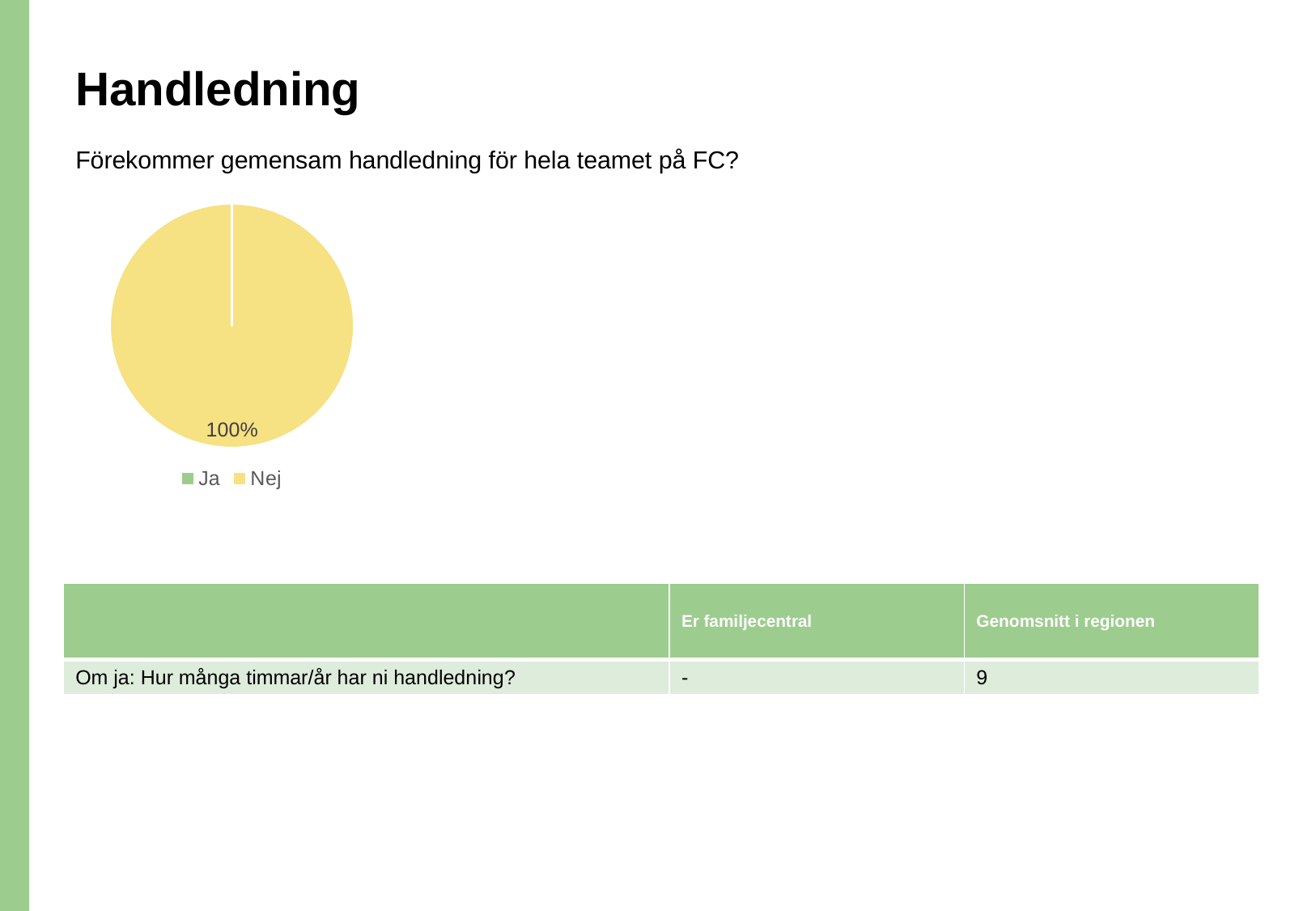
Which category has the smaller share of the pie, Ja or Nej? Ja What share of the pie does the Nej slice represent? 100% What is the only percentage label printed on the pie chart? 100% What kind of chart is shown on the slide? pie chart How many entries does the legend of the pie chart list? 2 Which is larger in the pie chart, Ja or Nej? Nej What question does the pie chart answer, according to the text above it? Förekommer gemensam handledning för hela teamet på FC? What colour is the Nej slice in the pie chart? yellow Which category has the largest share of the pie? Nej